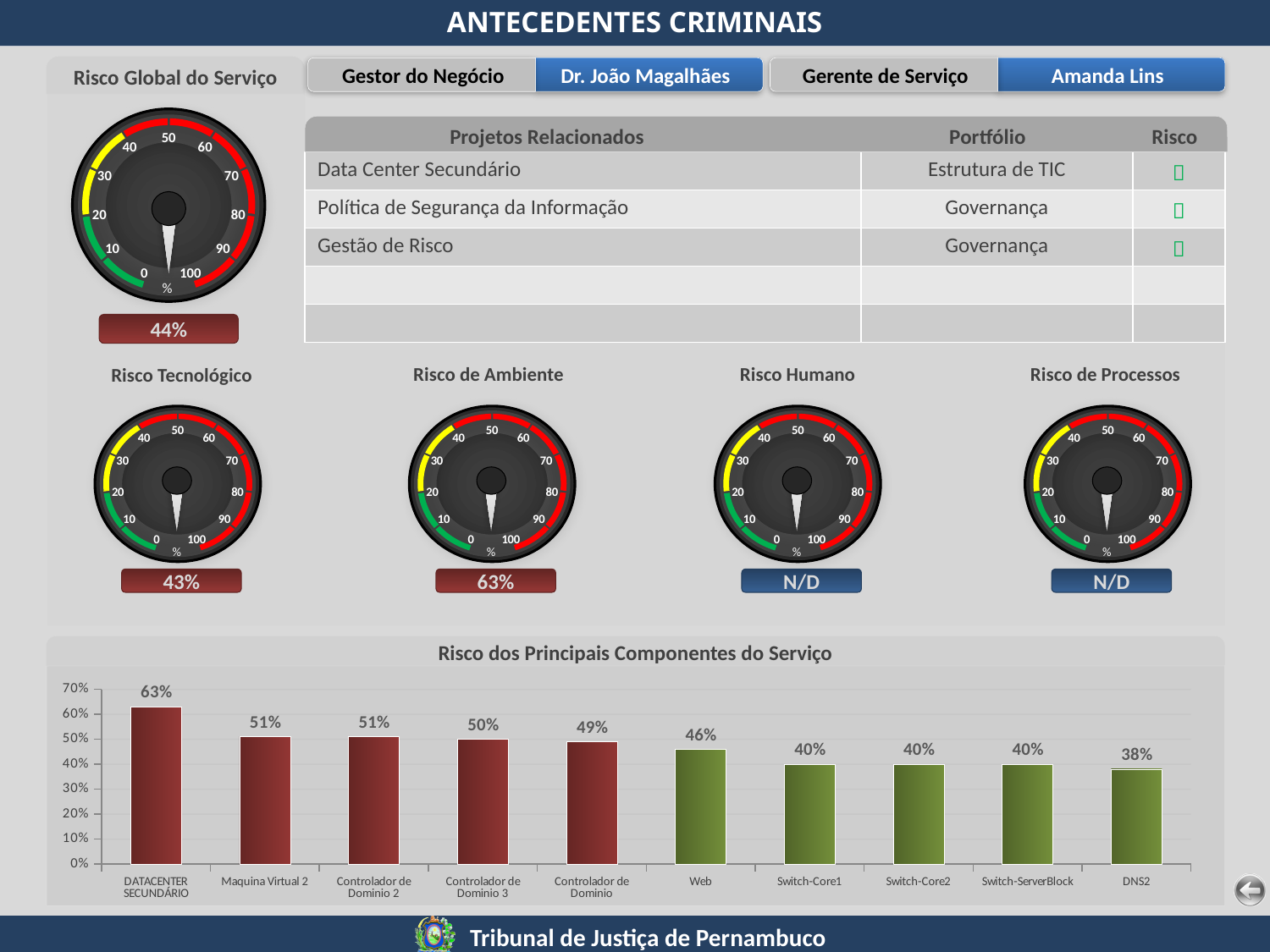
What value is shown below the 'Risco de Ambiente' gauge? 63% In the chart 'Risco dos Principais Componentes do Serviço', do the values rise or fall from left to right? Fall In the chart 'Risco dos Principais Componentes do Serviço', which is larger: Controlador de Dominio 3 or Switch-Core1? Controlador de Dominio 3 In the chart 'Risco dos Principais Componentes do Serviço', which component has the lowest value? DNS2 In the chart 'Risco dos Principais Componentes do Serviço', what is the value for Web? 46% In the chart 'Risco dos Principais Componentes do Serviço', how many components are plotted? 10 In the chart 'Risco dos Principais Componentes do Serviço', what is the value for DNS2? 38% What kind of chart is 'Risco dos Principais Componentes do Serviço'? Bar chart In the chart 'Risco dos Principais Componentes do Serviço', which component has the highest value? DATACENTER SECUNDÁRIO What value is shown below the 'Risco Global do Serviço' gauge? 44% In the chart 'Risco dos Principais Componentes do Serviço', what is the value for DATACENTER SECUNDÁRIO? 63% In the chart 'Risco dos Principais Componentes do Serviço', what is the difference between DATACENTER SECUNDÁRIO and Web? 17%